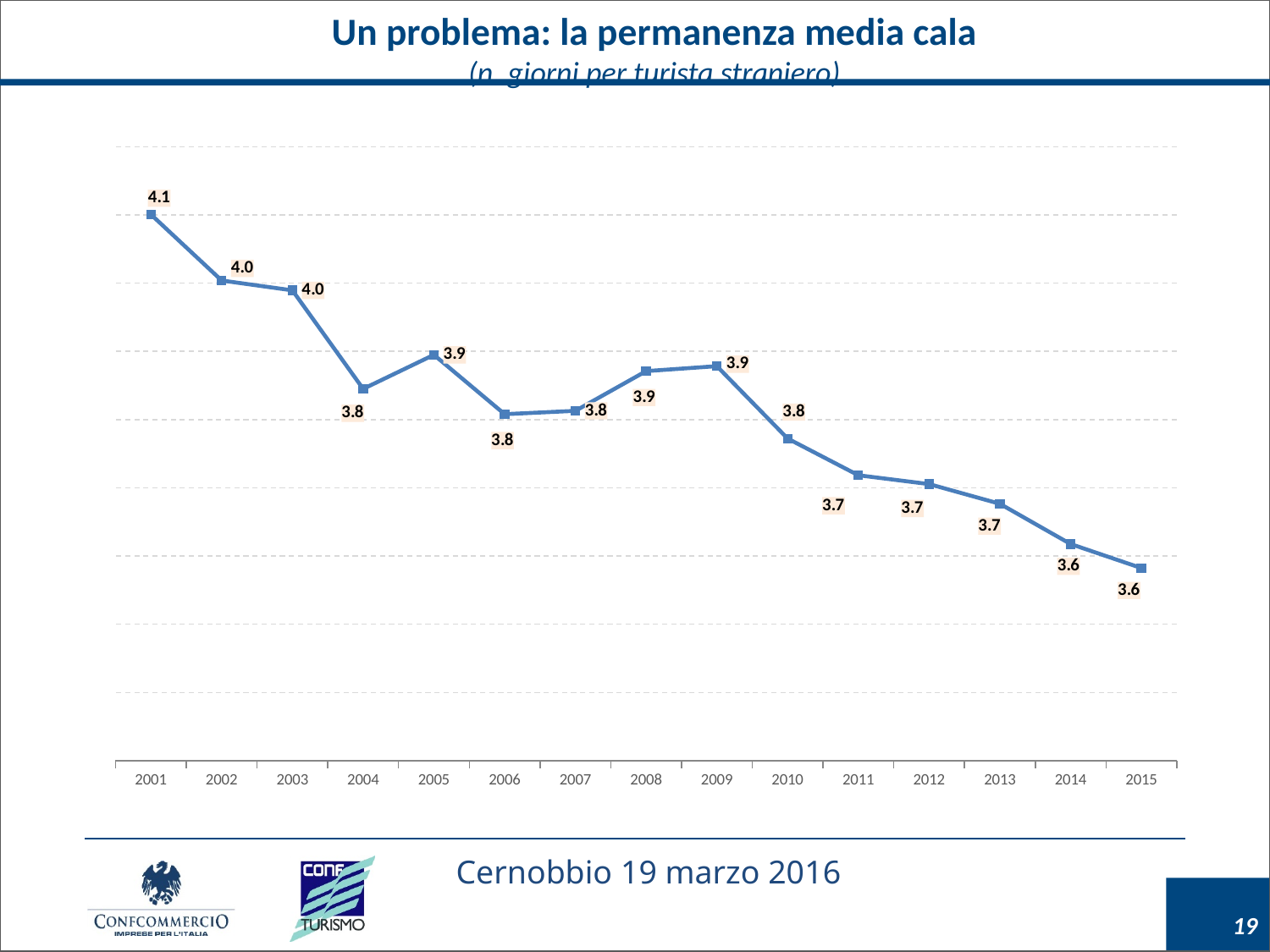
What is the title of the chart? Un problema: la permanenza media cala Do the values generally rise or fall from 2001 to 2015? fall What is the value for 2009? 3.9 How many years are plotted on the x axis? 15 What is the difference between the values for 2003 and 2004? 0.2 What is the difference between the values for 2001 and 2015? 0.5 Which year has the highest value? 2001 What is the value for 2001? 4.1 What kind of chart is shown on the slide? line chart What is the value for 2015? 3.6 Which is larger, the value for 2005 or the value for 2004? 2005 What is the value for 2011? 3.7